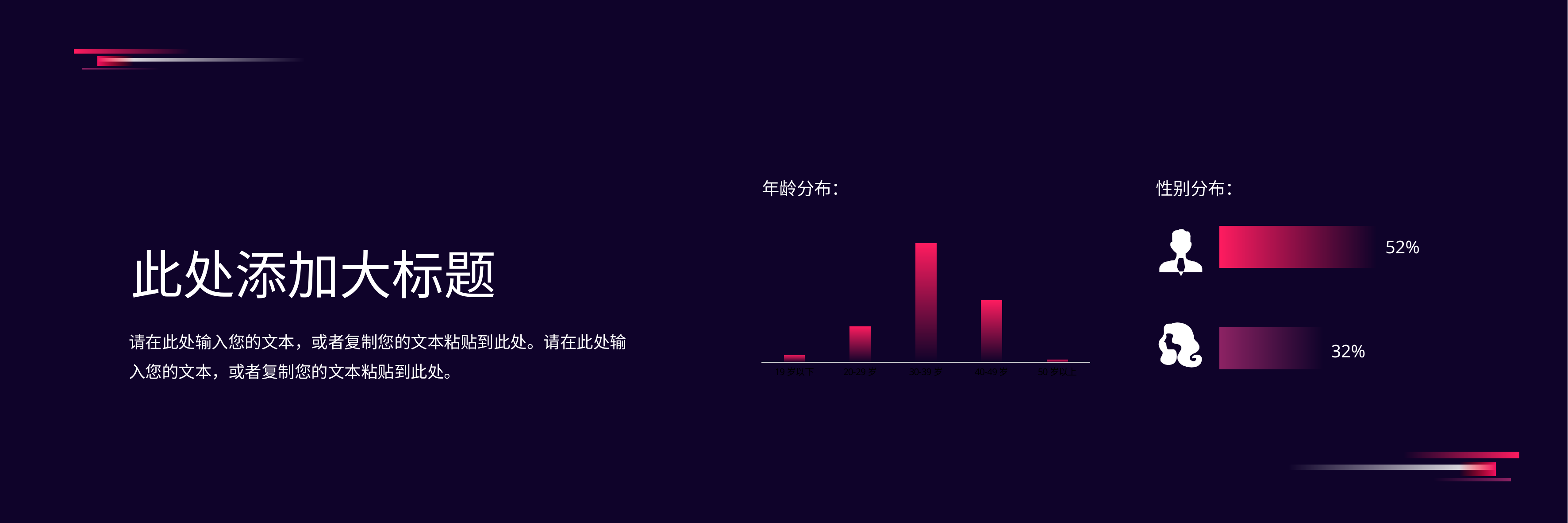
In the 年龄分布 chart, which bar is taller: 30-39 岁 or 40-49 岁? 30-39 岁 In the 年龄分布 chart, which age group has the lowest bar? 50 岁以上 In the 年龄分布 chart, which age group has the highest bar? 30-39 岁 What is the title of the bar chart on the slide? 年龄分布 In the 性别分布 graphic, what is the difference between the male and female percentages? 20% In the 性别分布 graphic, what percentage is shown for the male figure? 52% In the 年龄分布 chart, which bar is taller: 20-29 岁 or 40-49 岁? 40-49 岁 In the 性别分布 graphic, what percentage is shown for the female figure? 32% How many age categories are shown in the 年龄分布 chart? 5 In the 性别分布 graphic, which is larger: the male percentage or the female percentage? male (52%) What kind of chart is the 年龄分布 chart? bar chart